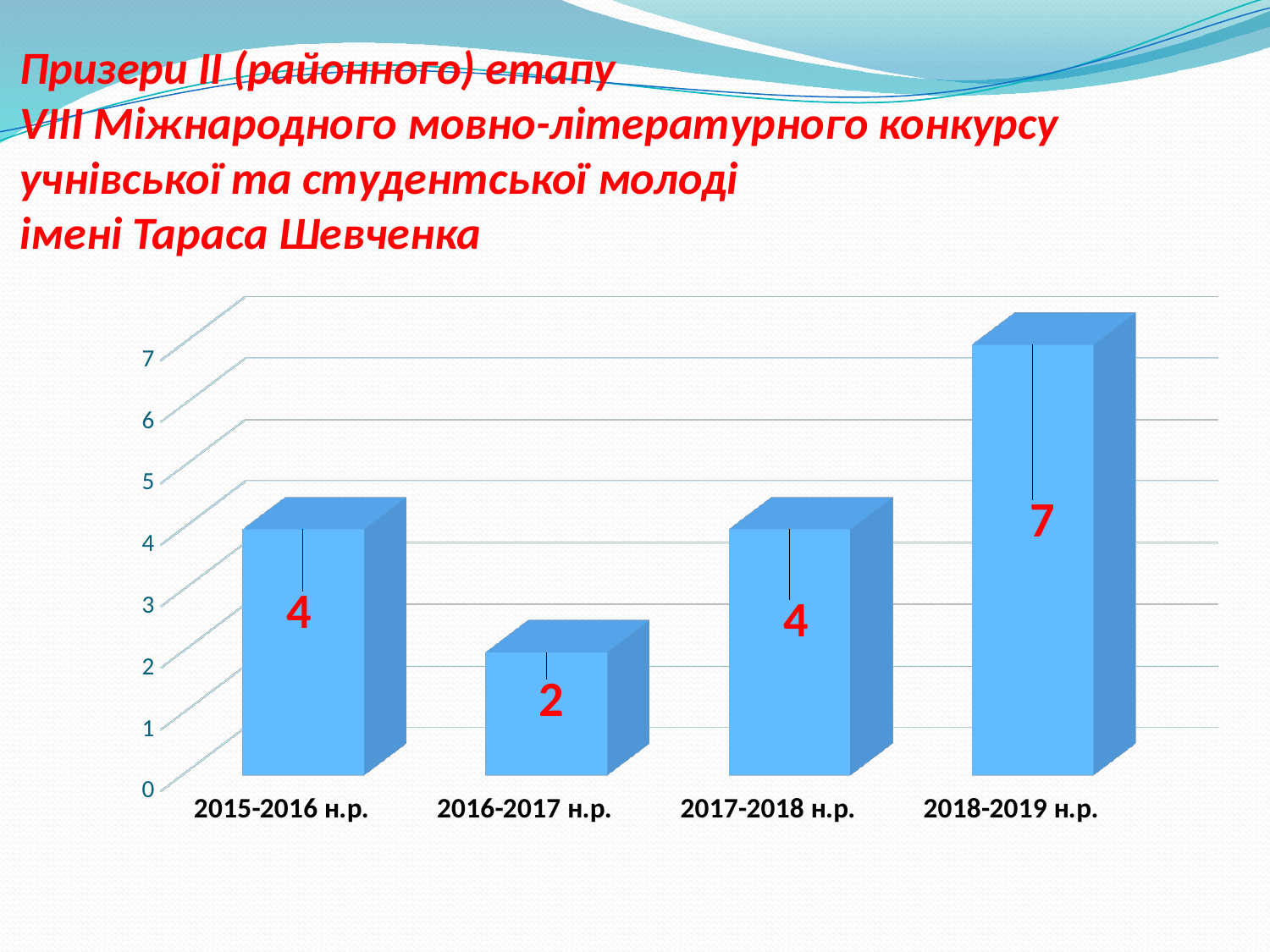
Which is larger, the value for 2015-2016 н.р. or the value for 2016-2017 н.р.? 2015-2016 н.р. What is the difference between the values for 2018-2019 н.р. and 2016-2017 н.р.? 5 Which year has the lowest value? 2016-2017 н.р. What is the value for 2015-2016 н.р.? 4 What is the value for 2017-2018 н.р.? 4 How many years are shown on the chart? 4 What kind of chart is shown on the slide? bar chart What is the difference between the values for 2018-2019 н.р. and 2017-2018 н.р.? 3 Which year has the highest value? 2018-2019 н.р. What is the value for 2016-2017 н.р.? 2 What is the value for 2018-2019 н.р.? 7 Is the value for 2018-2019 н.р. greater or less than 5? greater